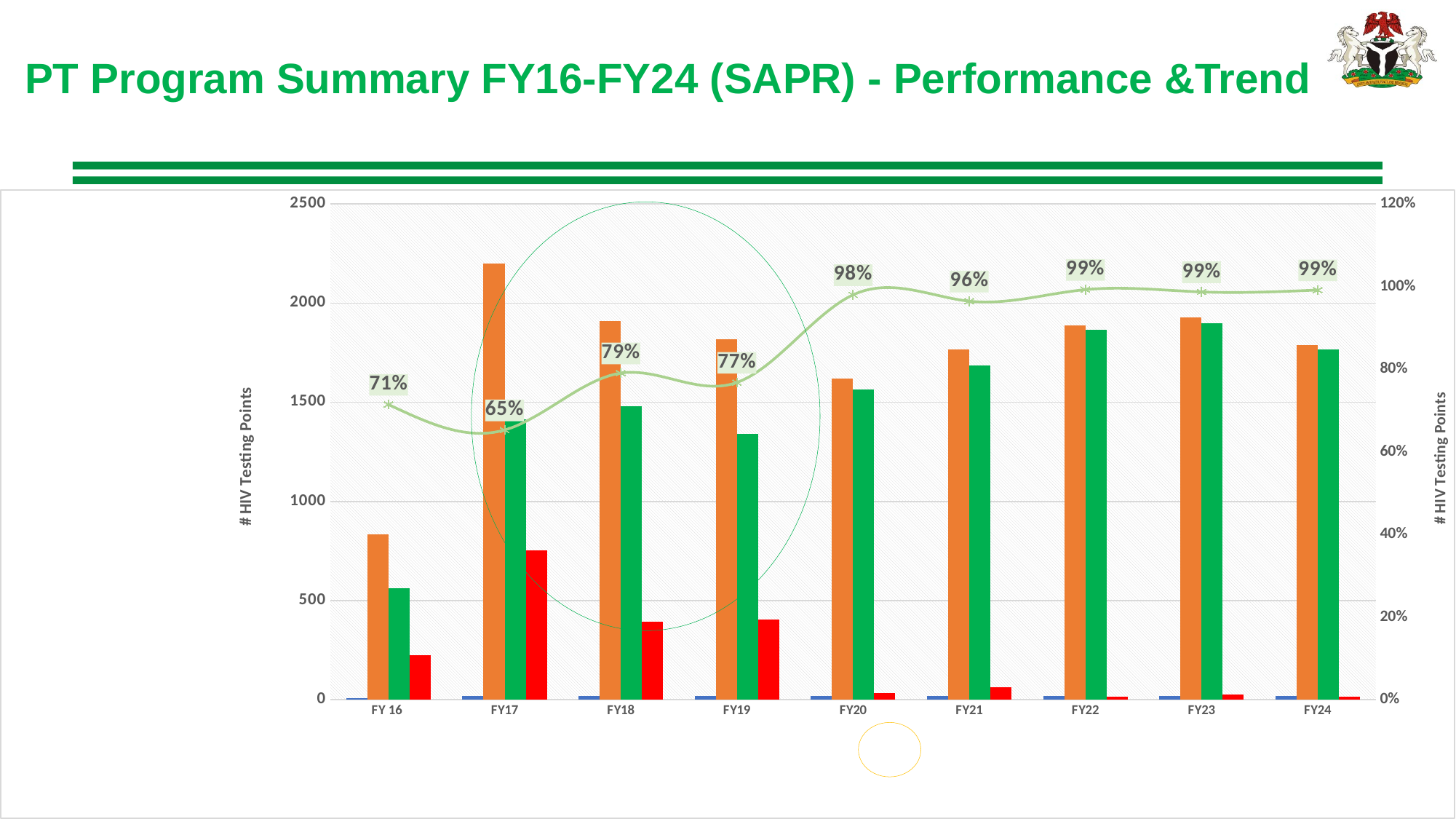
Does the percentage line generally rise or fall from FY 16 to FY24? Rise Is the value of the green bar for FY19 greater or less than 1000? greater Is the value of the red bar for FY 16 greater or less than 500? less What kind of chart is shown on the slide? Combination bar and line chart Which fiscal year has the lowest percentage labelled on the line? FY17 Is the value of the orange bar for FY17 greater or less than 2000? greater What percentage is labelled on the line for FY 16? 71% What percentage is labelled on the line for FY17? 65% How many fiscal years are shown on the x axis? 9 Which has the higher line percentage label, FY18 or FY19? FY18 What is the difference in percentage points between the line labels for FY20 and FY19? 21 percentage points What percentage is labelled on the line for FY20? 98%